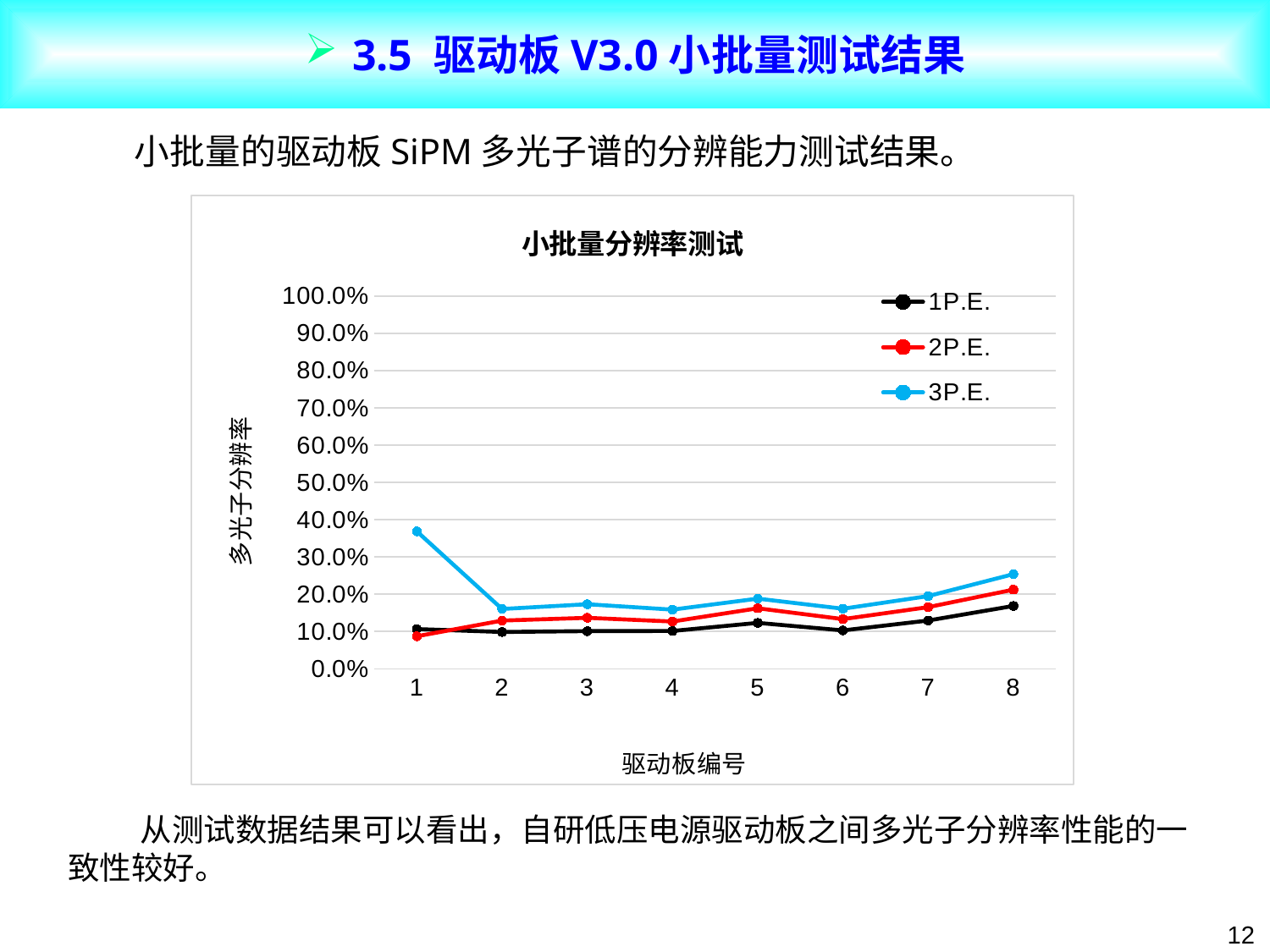
How many driver board numbers are plotted along the x axis? 8 How many series does the legend list? 3 At driver board 1, which series has the larger value, 1P.E. or 3P.E.? 3P.E. For which driver board number is the 3P.E. value highest? 1 Which colour is used for the 2P.E. series? red Is the 1P.E. value for driver board 8 greater or less than 10.0%? greater Is the 3P.E. value for driver board 1 greater or less than 30.0%? greater What kind of chart is shown on the slide? line chart For which driver board number is the 1P.E. value highest? 8 What is the title of the chart? 小批量分辨率测试 Does the 3P.E. value rise or fall from driver board 1 to driver board 2? fall Is the 2P.E. value for driver board 8 greater or less than 30.0%? less